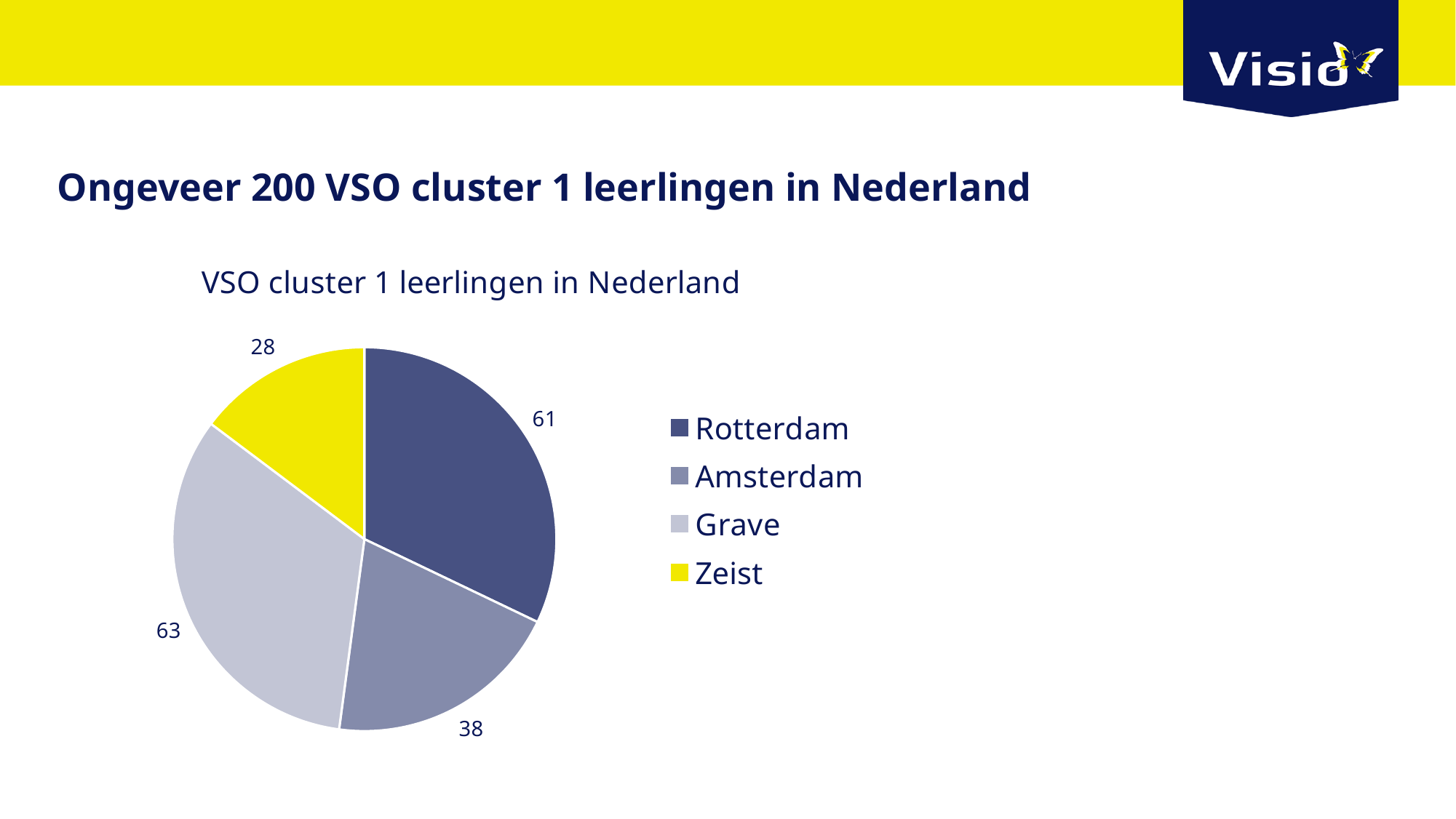
What is the value for Grave? 63 How many categories does the pie chart have? 4 What is the value for Amsterdam? 38 What is the title of the chart? VSO cluster 1 leerlingen in Nederland What is the value for Zeist? 28 Which category has the smallest value? Zeist What type of chart is shown on the slide? pie chart What is the value for Rotterdam? 61 What is the total of all four slices in the pie chart? 190 Which is larger, the value for Amsterdam or the value for Zeist? Amsterdam What is the difference between the values for Rotterdam and Amsterdam? 23 Which category has the largest value? Grave